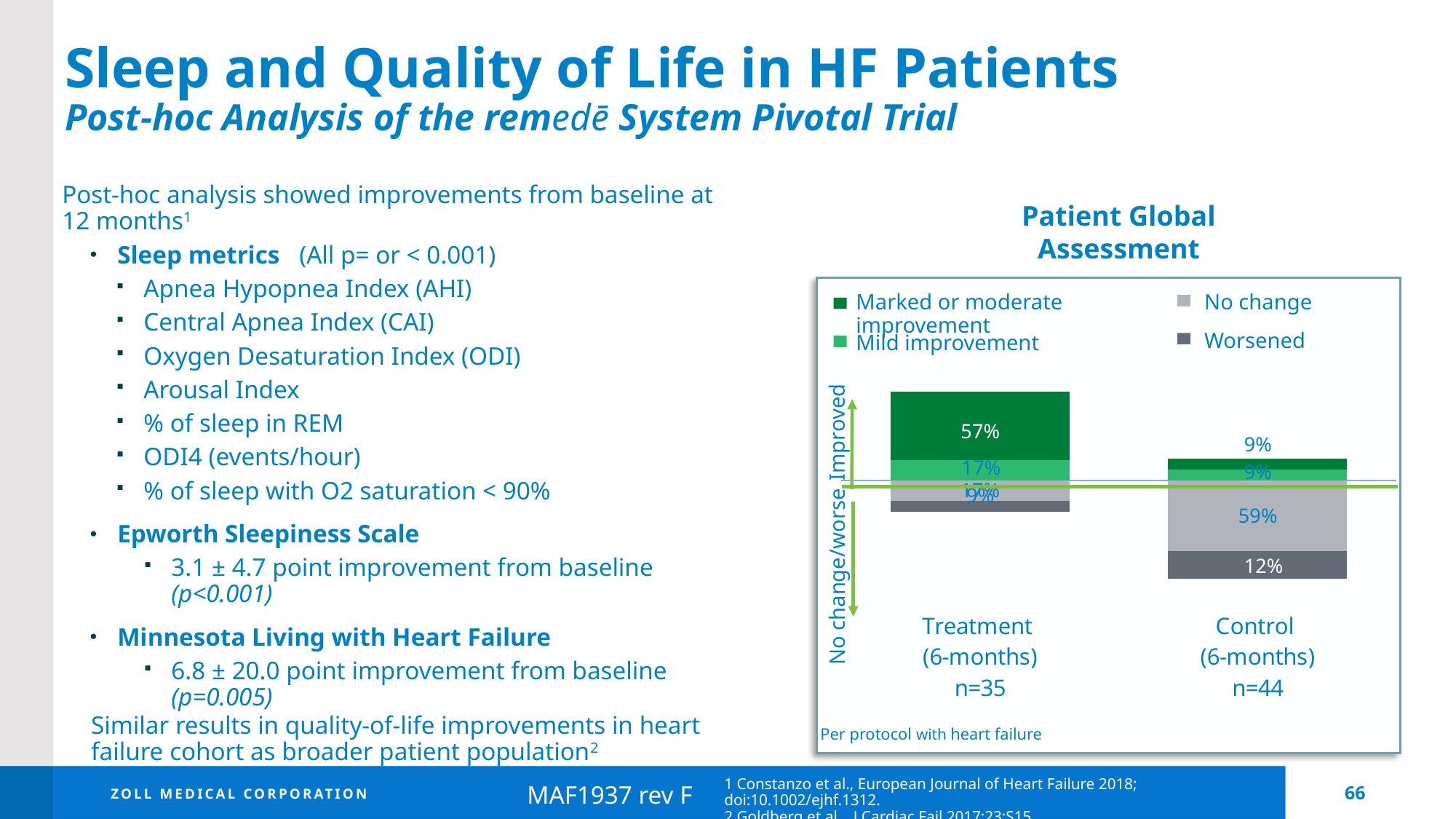
How many categories does the legend of the Patient Global Assessment chart list? 4 What percentage of the Control (6-months) group worsened? 12% What percentage of the Control (6-months) group reported marked or moderate improvement? 9% What is the difference in percentage points between the marked or moderate improvement share in the Treatment group and in the Control group? 48 percentage points How many patients were in the Control (6-months) group? n=44 How many groups (bars) are shown in the Patient Global Assessment chart? 2 What percentage of the Treatment (6-months) group reported marked or moderate improvement? 57% What percentage of the Treatment (6-months) group reported mild improvement? 17% What type of chart is the Patient Global Assessment? Stacked bar chart Which group has the larger share of marked or moderate improvement, Treatment or Control? Treatment What percentage of the Control (6-months) group reported no change? 59% What is the difference in percentage points between the no change share and the worsened share in the Control group? 47 percentage points